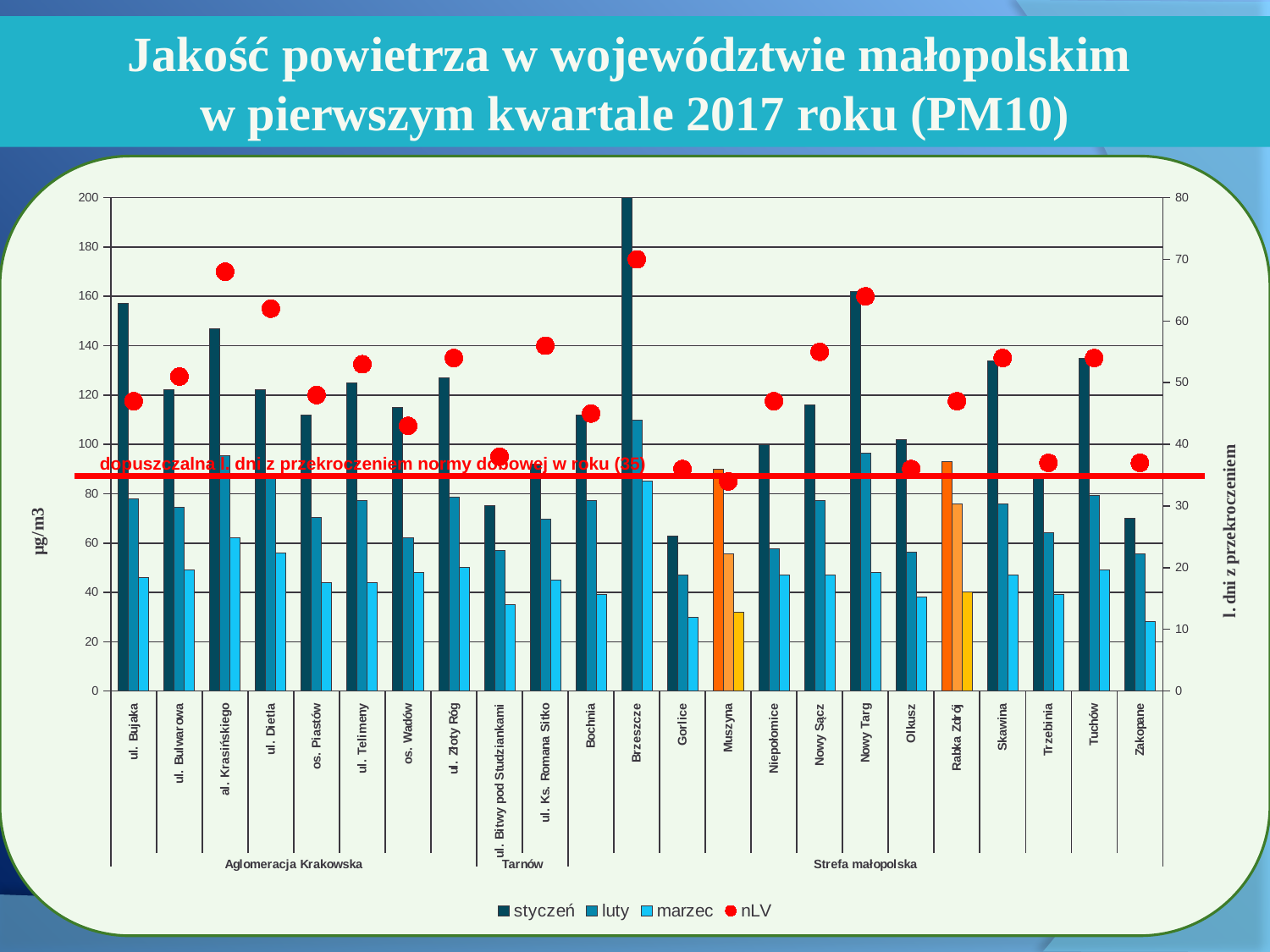
How many measurement stations (categories) are shown on the x axis? 23 Which station has the highest nLV value? Brzeszcze How many series does the legend list? 4 Which station has the highest styczeń (January) value? Brzeszcze What kind of chart is shown on the slide? bar chart (with nLV plotted as red points) Which station has the lowest styczeń (January) value? Gorlice Is the styczeń value for ul. Bujaka greater or less than 140? greater Is the styczeń value for Gorlice greater or less than 80? less Which has the larger styczeń value, Nowy Targ or Nowy Sącz? Nowy Targ What unit is shown on the left vertical axis? µg/m3 What value does the horizontal red line mark, according to its label? 35 (dopuszczalna l. dni z przekroczeniem normy dobowej w roku) Is the nLV value for al. Krasińskiego greater or less than 60? greater